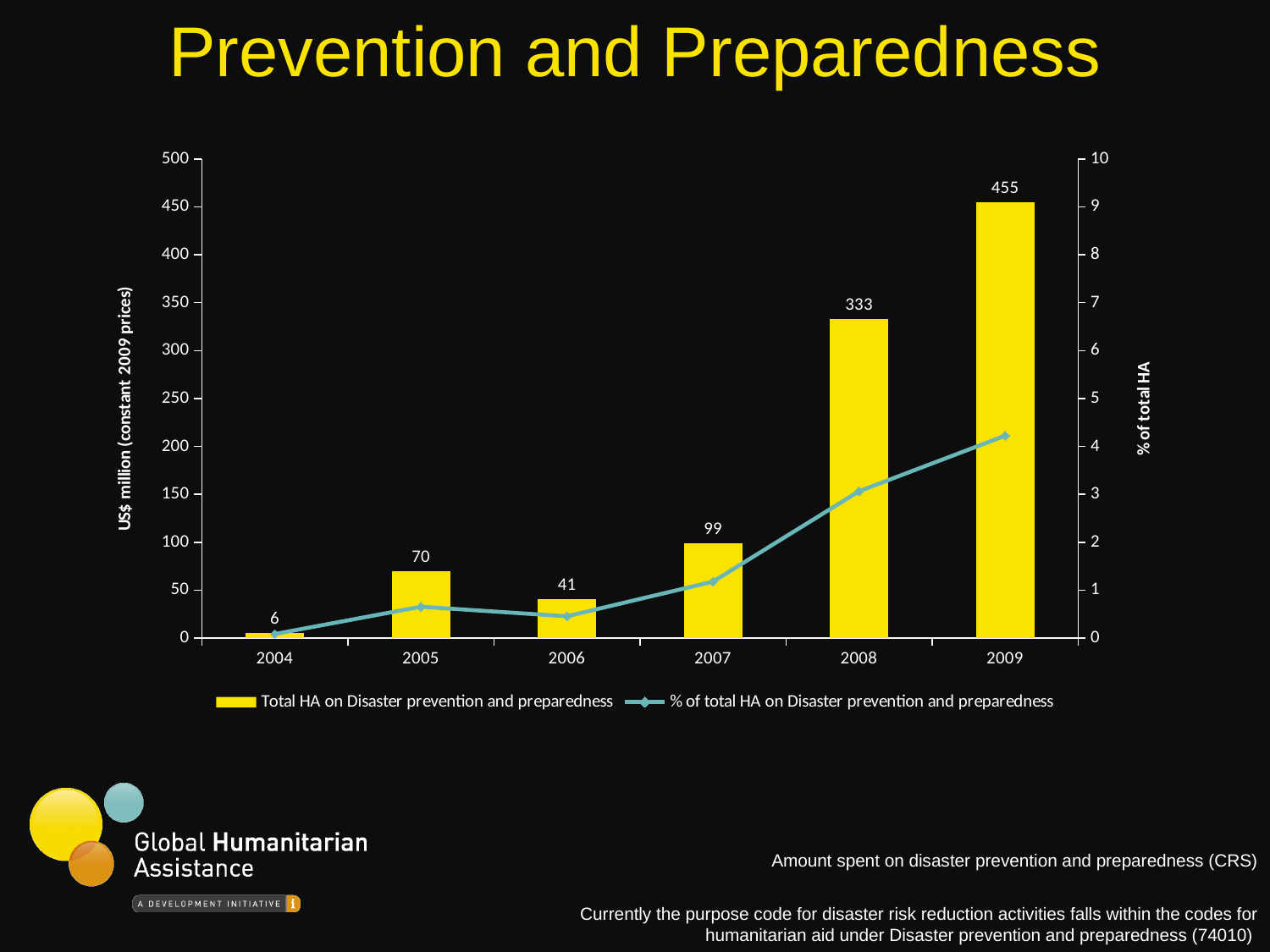
What is the value of Total HA on Disaster prevention and preparedness for 2009? 455 Is the % of total HA on Disaster prevention and preparedness for 2009 greater or less than 4? greater How many years are shown on the x axis of the chart? 6 What is the difference between the Total HA on Disaster prevention and preparedness in 2009 and 2008? 122 What is the value of Total HA on Disaster prevention and preparedness for 2006? 41 Which year has the lowest Total HA on Disaster prevention and preparedness? 2004 Is the % of total HA on Disaster prevention and preparedness for 2007 greater or less than 2? less How many series does the legend list? 2 What is the value of Total HA on Disaster prevention and preparedness for 2004? 6 Which year has a larger Total HA on Disaster prevention and preparedness, 2005 or 2006? 2005 Does the Total HA on Disaster prevention and preparedness rise or fall from 2006 to 2009? rise Which year has the highest Total HA on Disaster prevention and preparedness? 2009